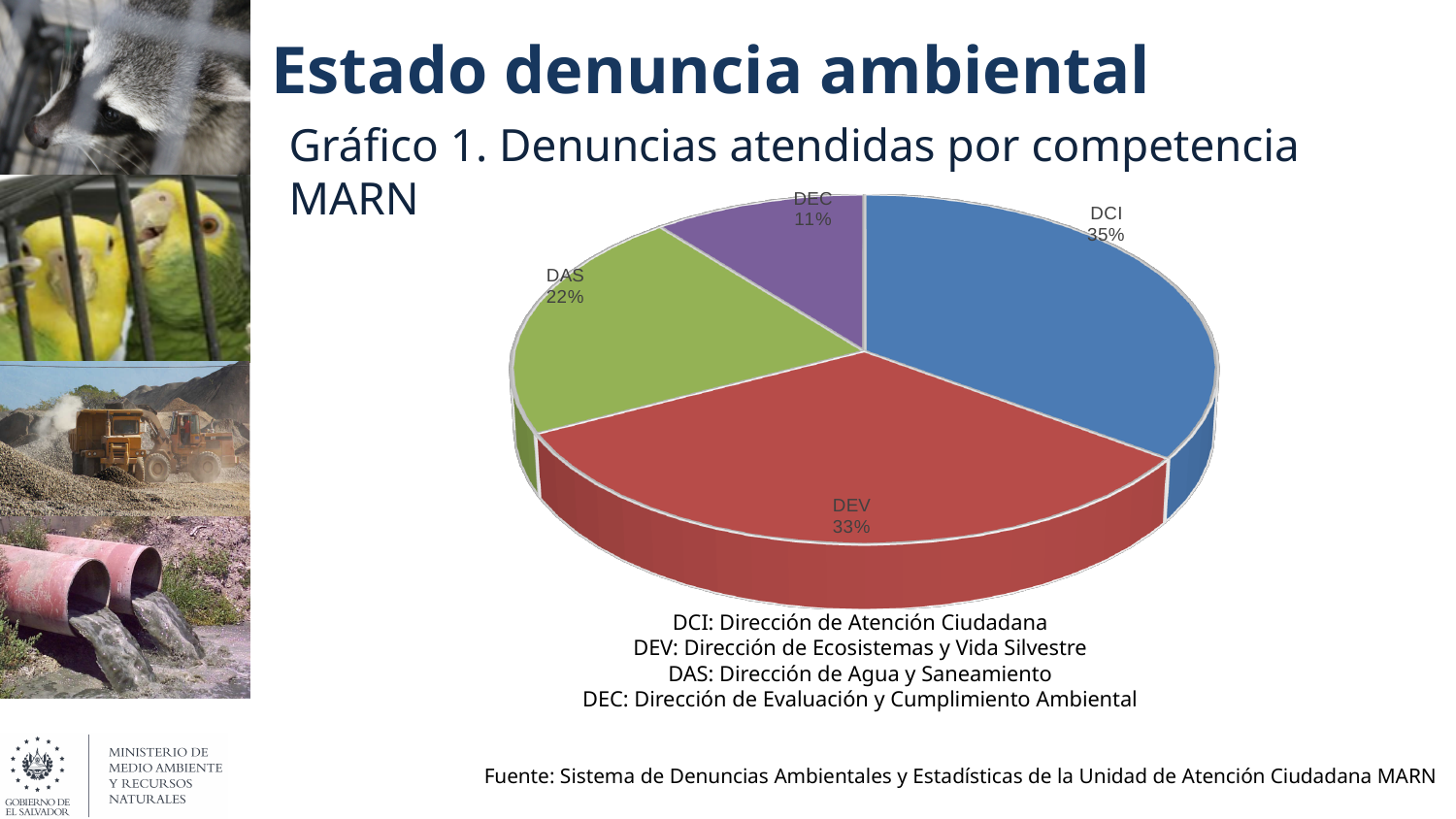
What colour is the DEV slice of the pie? Red Which category has the smallest share of the pie? DEC What share of the pie does DEC represent? 11% What share of the pie does DEV represent? 33% What kind of chart is shown on the slide? Pie chart What share of the pie does DCI represent? 35% What is the difference in percentage points between the DAS and DEC shares? 11 What is the difference in percentage points between the DCI and DEV shares? 2 What share of the pie does DAS represent? 22% How many categories are shown in the pie chart? 4 Which is larger, the share for DAS or the share for DEC? DAS Which category has the largest share of the pie? DCI